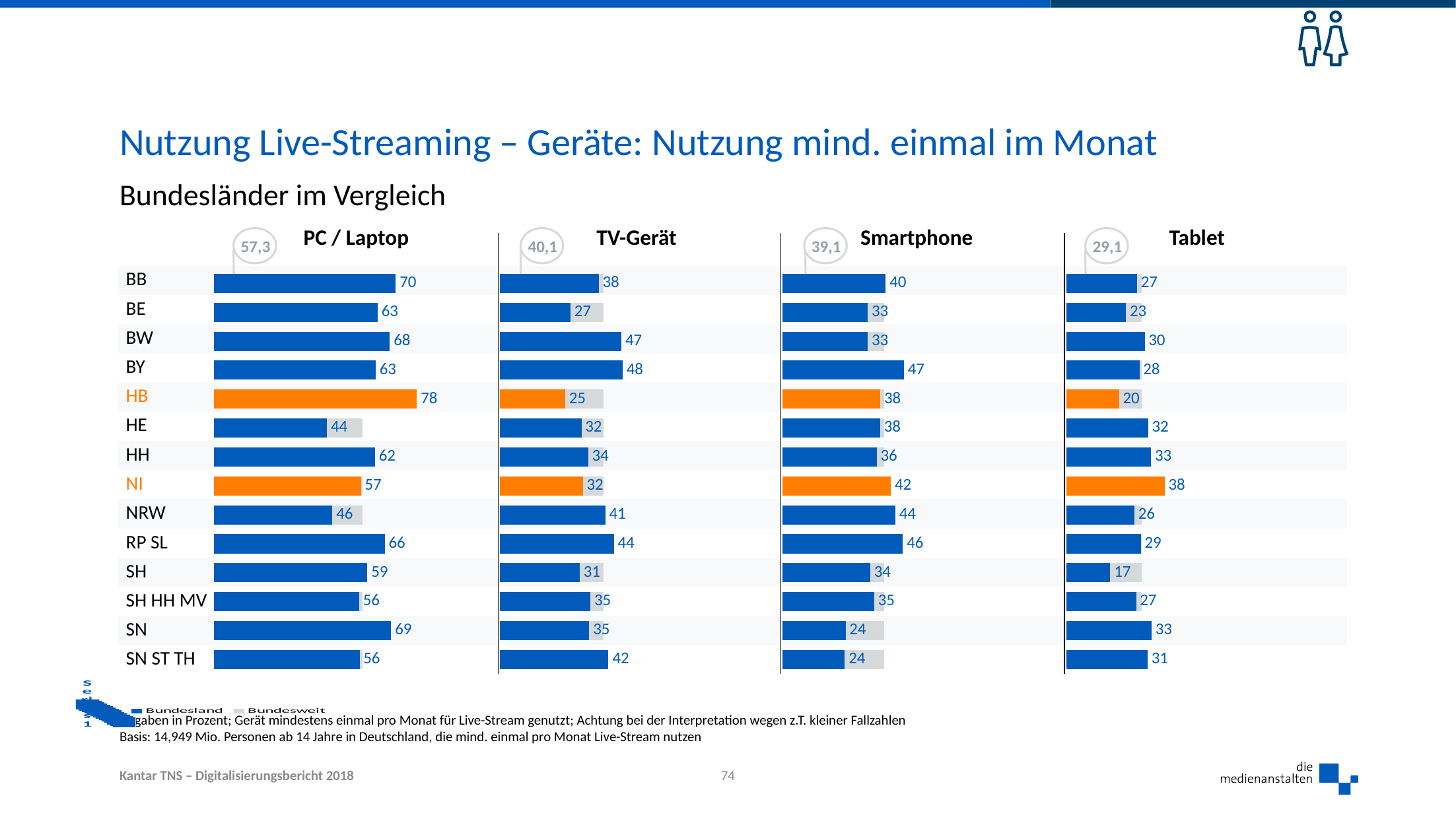
In the Tablet chart, which Bundesland has the highest value? NI In the TV-Gerät chart, which Bundesland has the highest value? BY In the Smartphone chart, what is the difference between the values for BY and SN? 23 In the Tablet chart, which Bundesland has the lowest value? SH In the Smartphone chart, what is the value for NRW? 44 How many Bundesländer are listed in the TV-Gerät chart? 14 What kind of chart is used for the Smartphone data? bar chart What is the Bundesweit value shown in the circle above the Tablet chart? 29,1 In the PC / Laptop chart, which is larger, the value for BB or the value for SN? BB In the PC / Laptop chart, what is the value for HB? 78 In the PC / Laptop chart, which Bundesland has the lowest value? HE In the TV-Gerät chart, what is the value for BY? 48